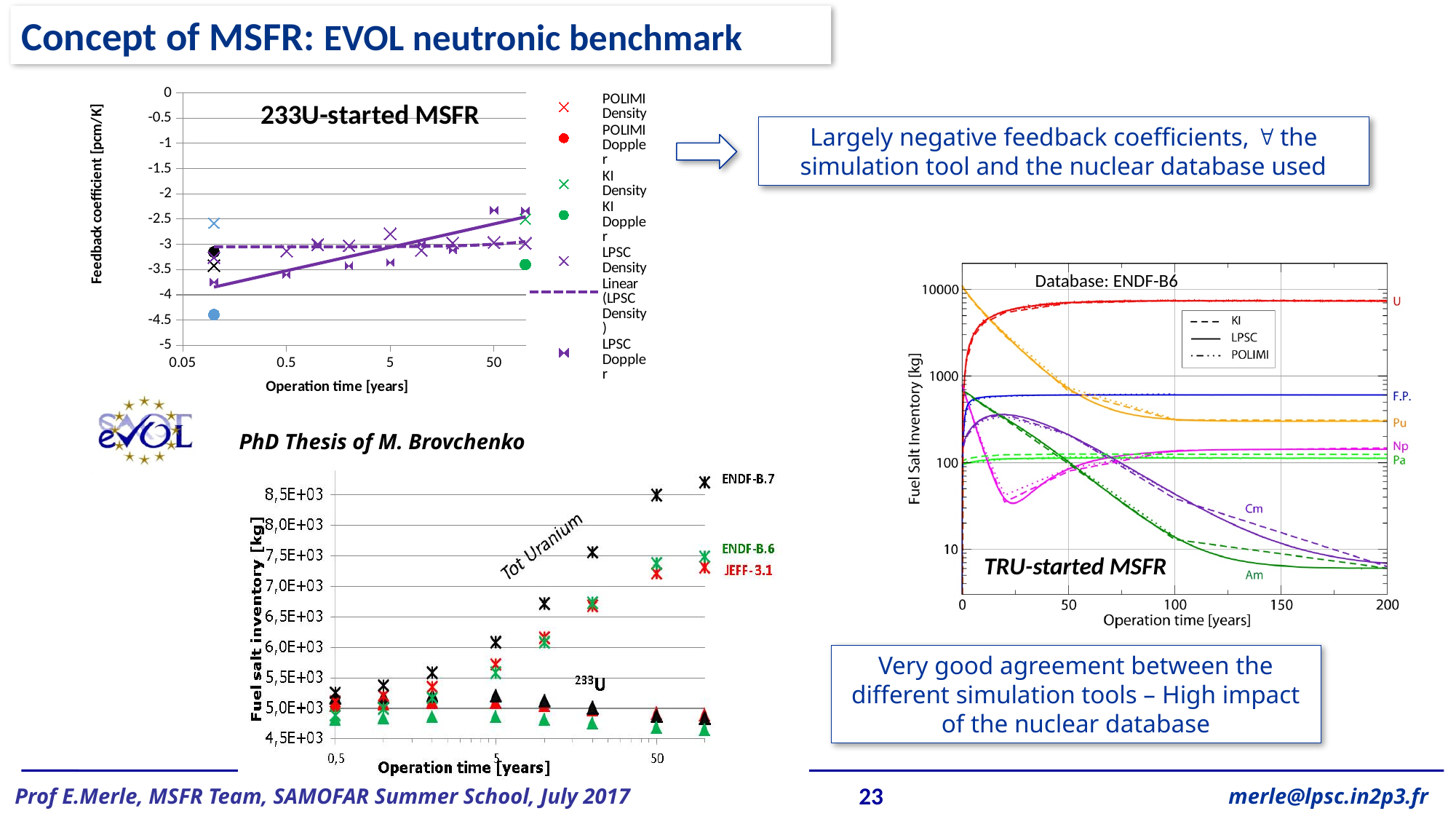
In the right chart 'TRU-started MSFR', which element has the lowest fuel salt inventory at 100 years? Am In the right chart 'TRU-started MSFR', does the Pu inventory rise or fall between 0 and 100 years? fall What kind of chart is the top-left chart titled '233U-started MSFR'? scatter chart In the top-left chart '233U-started MSFR', is the KI Density value at the earliest operation time greater or less than -3? greater In the right chart 'TRU-started MSFR', is the U inventory at 200 years greater or less than 1000 kg? greater In the right chart 'TRU-started MSFR', which element has the highest fuel salt inventory at 200 years? U In the top-left chart '233U-started MSFR', how many entries does the legend list? 7 In the bottom-left chart of fuel salt inventory, which nuclear database gives the highest Tot Uranium value at the last operation time? ENDF-B.7 In the top-left chart '233U-started MSFR', what is the label of the y axis? Feedback coefficient [pcm/K] In the right chart 'TRU-started MSFR', which nuclear database is used? ENDF-B6 In the right chart 'TRU-started MSFR', how many simulation tools does the legend list? 3